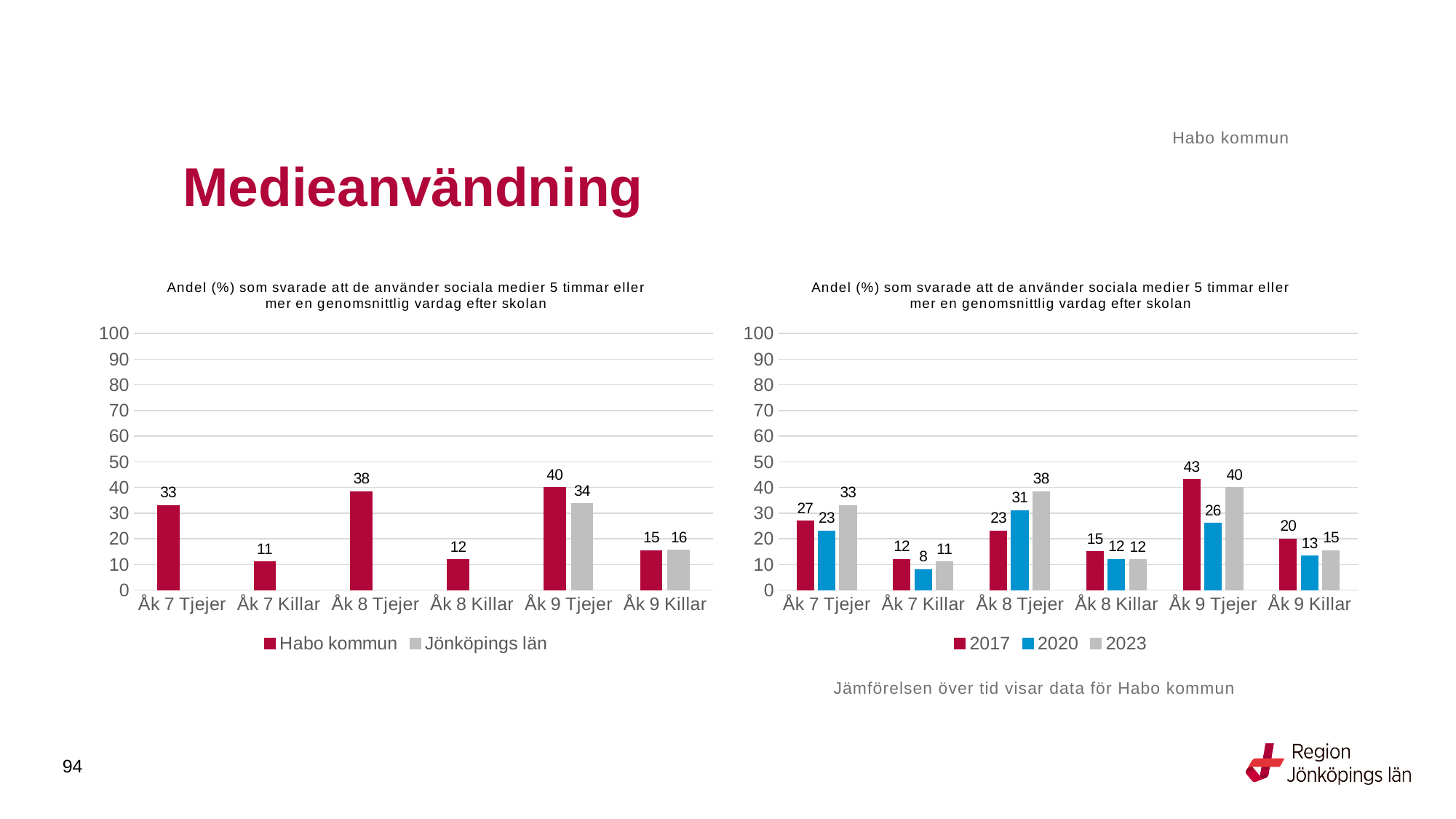
In the left chart, which category has the lowest value for Habo kommun? Åk 7 Killar In the left chart, what is the value for Jönköpings län for Åk 9 Killar? 16 In the left chart, what is the value for Habo kommun for Åk 9 Tjejer? 40 In the right chart, what is the value for 2020 for Åk 8 Tjejer? 31 In the left chart, what is the difference between Habo kommun and Jönköpings län for Åk 9 Tjejer? 6 In the right chart, what is the difference between the 2017 and 2020 values for Åk 9 Tjejer? 17 In the right chart, how many categories are shown on the x axis? 6 In the right chart, what is the value for 2017 for Åk 9 Tjejer? 43 In the right chart, which is larger for Åk 7 Tjejer: the 2017 value or the 2023 value? 2023 In the right chart, which category has the highest value for 2023? Åk 9 Tjejer In the left chart, how many series does the legend list? 2 What type of chart is the right chart? Bar chart